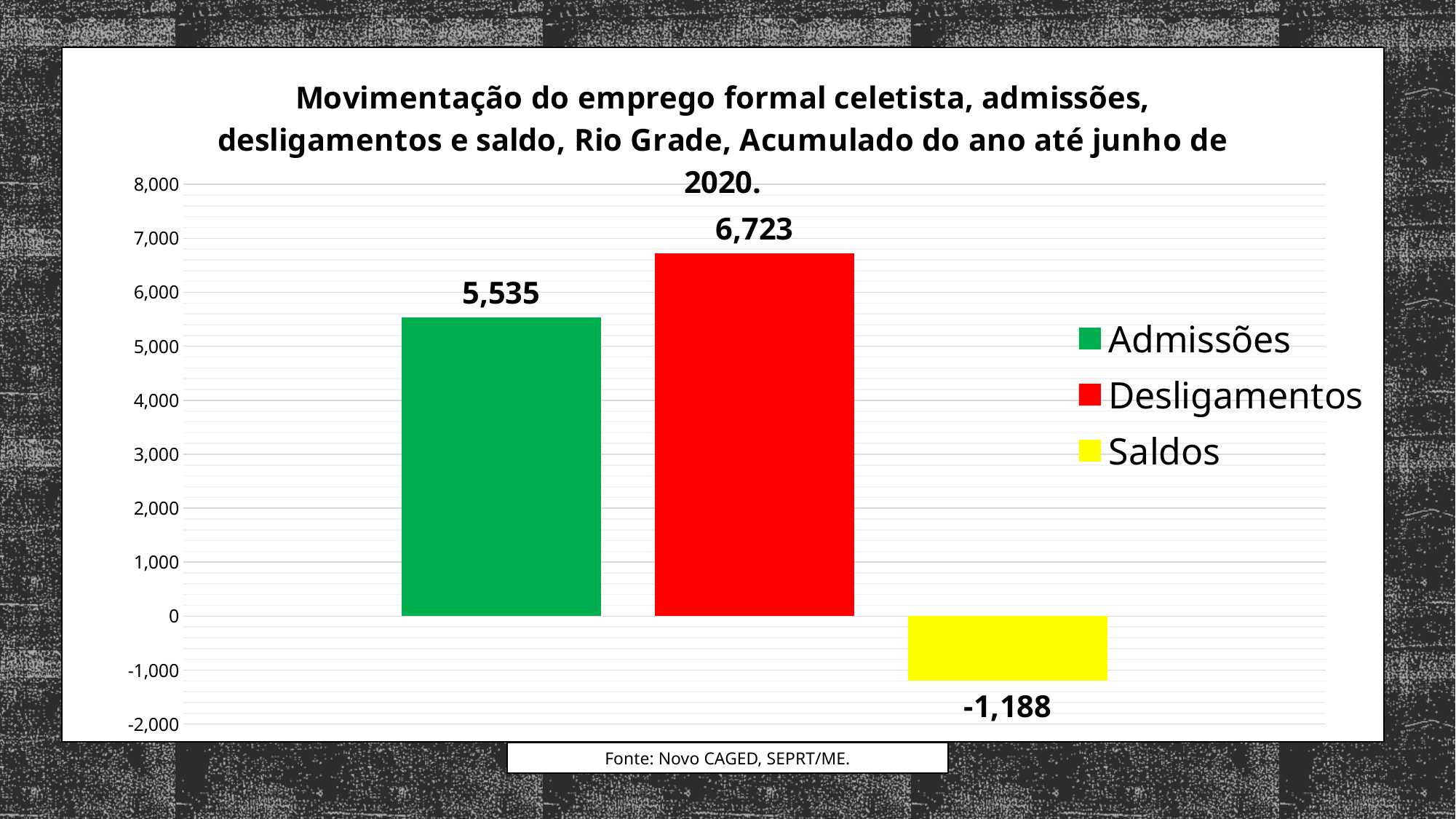
Which is larger, Admissões or Desligamentos? Desligamentos What is the value for Saldos? -1,188 How many bars are plotted in the chart? 3 How many series does the legend list? 3 What kind of chart is shown on the slide? Bar chart Which series has the lowest value? Saldos Is the value for Admissões greater or less than 5,000? greater What is the value for Desligamentos? 6,723 What is the value for Admissões? 5,535 What colour is the bar for Saldos? Yellow Which series has the highest value? Desligamentos What is the difference between Desligamentos and Admissões? 1,188